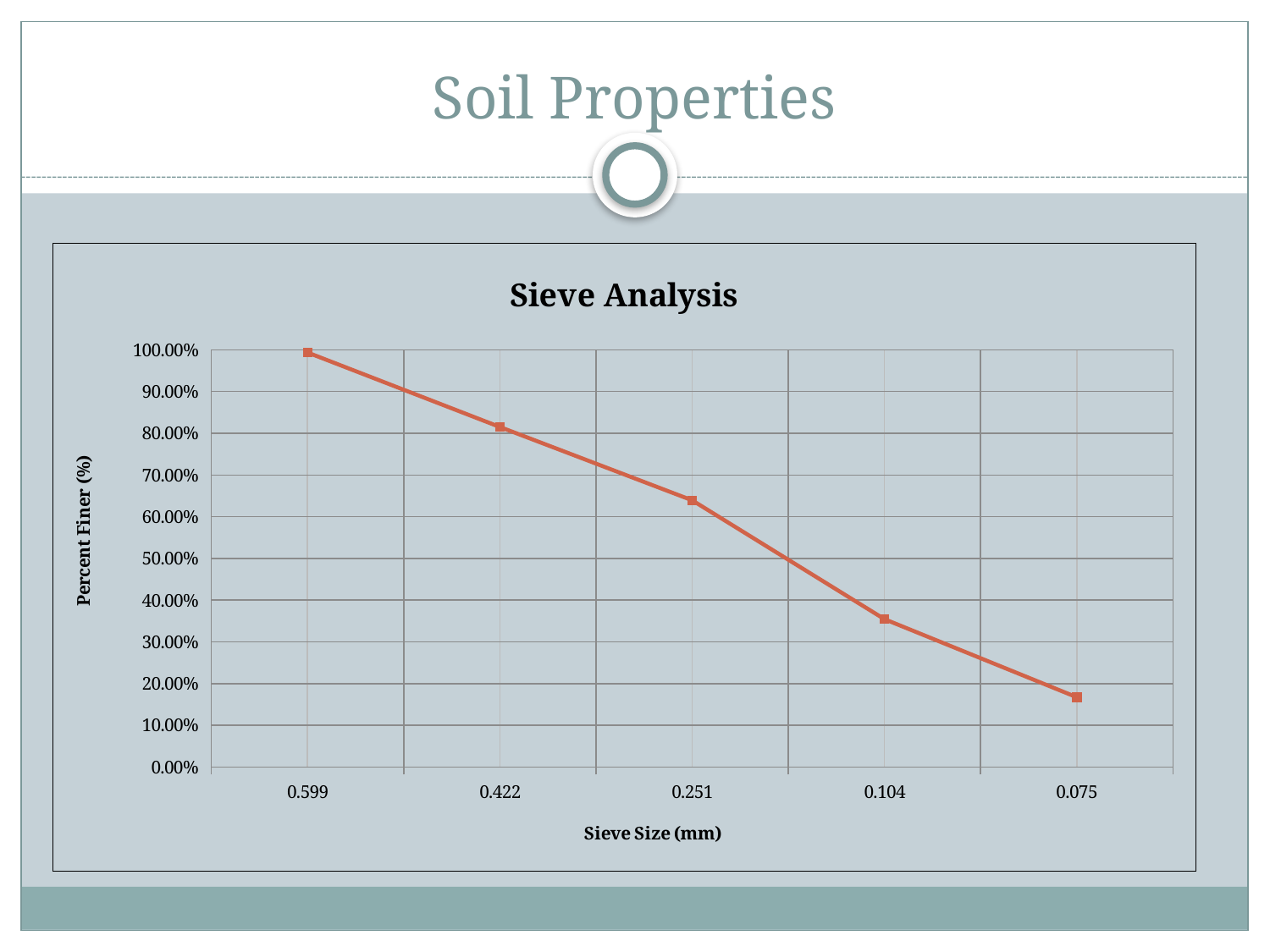
Do the percent finer values rise or fall from left to right along the x axis? fall Is the percent finer for sieve size 0.075 greater or less than 20.00%? less Which sieve size has the highest percent finer? 0.599 Which has a larger percent finer, sieve size 0.251 or sieve size 0.104? 0.251 Is the percent finer for sieve size 0.104 greater or less than 40.00%? less What is the label of the x axis? Sieve Size (mm) Which sieve size has the lowest percent finer? 0.075 Is the percent finer for sieve size 0.251 greater or less than 60.00%? greater How many data points are plotted on the chart? 5 What kind of chart is shown on the slide? line chart What is the title of the chart? Sieve Analysis